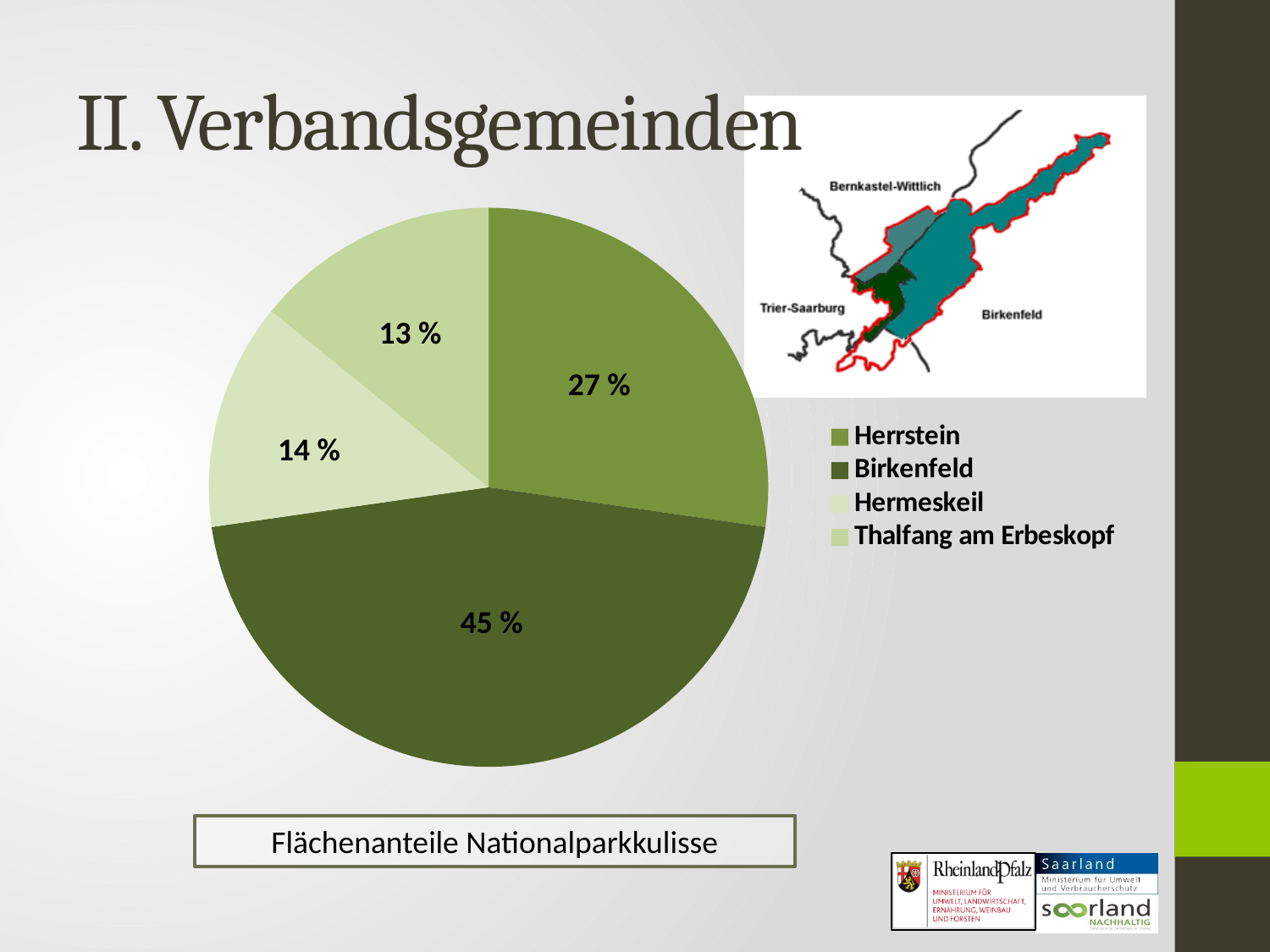
How many entries does the legend list? 4 Which is larger, the share of Herrstein or the share of Hermeskeil? Herrstein What share of the pie does Hermeskeil have? 14 % What share of the pie does Birkenfeld have? 45 % What is the caption shown below the pie chart? Flächenanteile Nationalparkkulisse What share of the pie does Thalfang am Erbeskopf have? 13 % Which category has the largest slice of the pie? Birkenfeld Which category has the smallest slice of the pie? Thalfang am Erbeskopf What kind of chart is shown on the slide? pie chart What is the difference between the shares of Birkenfeld and Herrstein? 18 % How many slices does the pie chart have? 4 What share of the pie does Herrstein have? 27 %